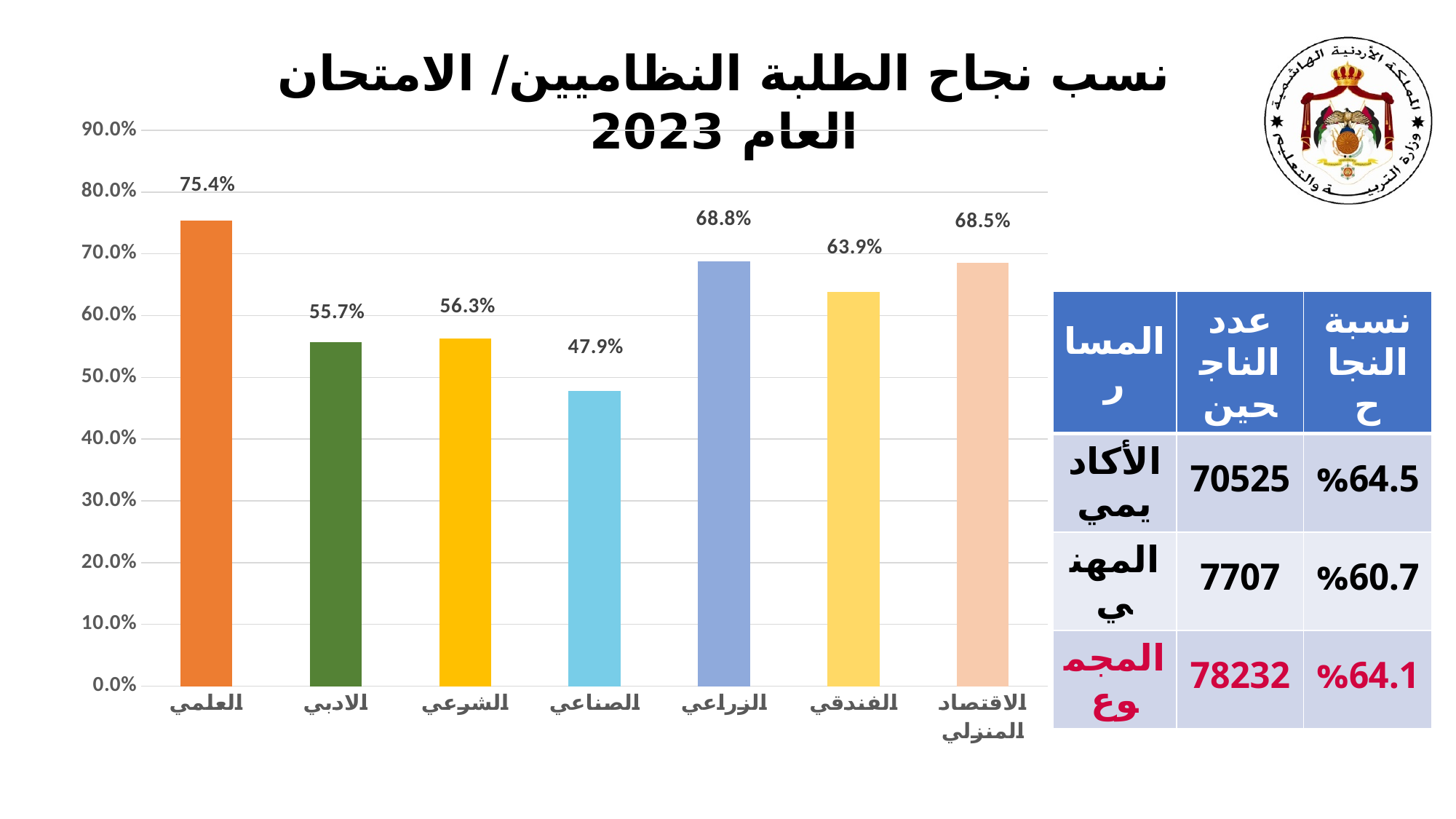
What is the value for الزراعي? 68.8% What is the title of the chart? نسب نجاح الطلبة النظاميين/ الامتحان العام 2023 What is the value for الفندقي? 63.9% What is the difference between the values for العلمي and الصناعي? 27.5% What is the value for الصناعي? 47.9% Which is larger, the value for الادبي or the value for الفندقي? الفندقي Is the value for الشرعي greater or less than 60.0%? less What kind of chart is shown on the slide? bar chart What is the value for العلمي? 75.4% Which category has the highest value? العلمي Which category has the lowest value? الصناعي How many categories are shown on the x axis? 7